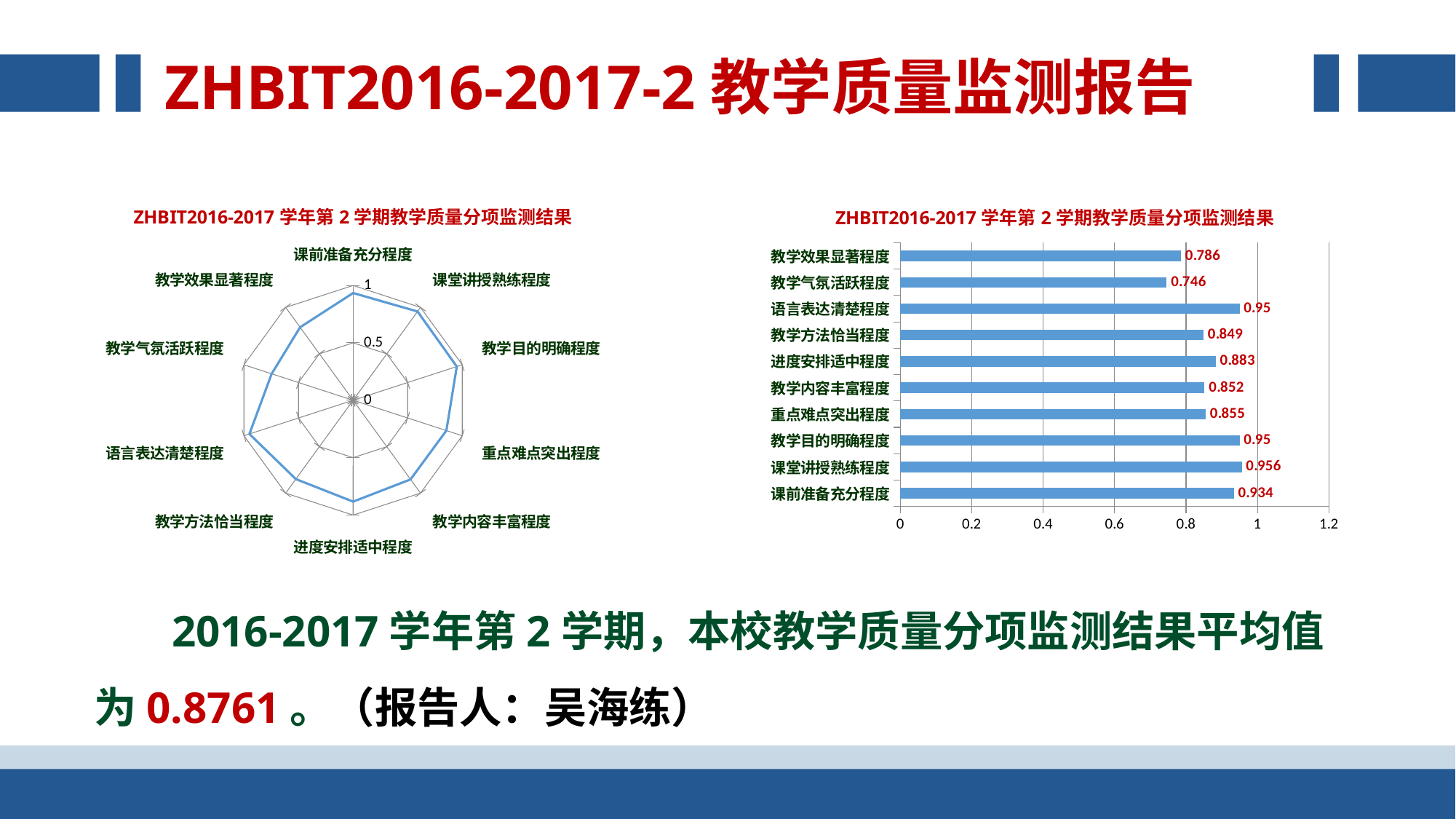
In the bar chart on the right, what is the value for 课堂讲授熟练程度? 0.956 What type of chart is shown on the left side of the slide? radar chart In the bar chart on the right, what is the value for 教学气氛活跃程度? 0.746 What type of chart is shown on the right side of the slide? bar chart In the radar chart on the left, is the value for 教学气氛活跃程度 greater or less than 0.5? greater In the bar chart on the right, which category has the lowest value? 教学气氛活跃程度 In the bar chart on the right, what is the difference between 课前准备充分程度 and 教学效果显著程度? 0.148 How many categories are shown in the bar chart on the right? 10 What is the title of the bar chart on the right? ZHBIT2016-2017学年第2学期教学质量分项监测结果 In the bar chart on the right, which category has the highest value? 课堂讲授熟练程度 In the bar chart on the right, what is the value for 进度安排适中程度? 0.883 In the bar chart on the right, which is larger: 教学方法恰当程度 or 重点难点突出程度? 重点难点突出程度